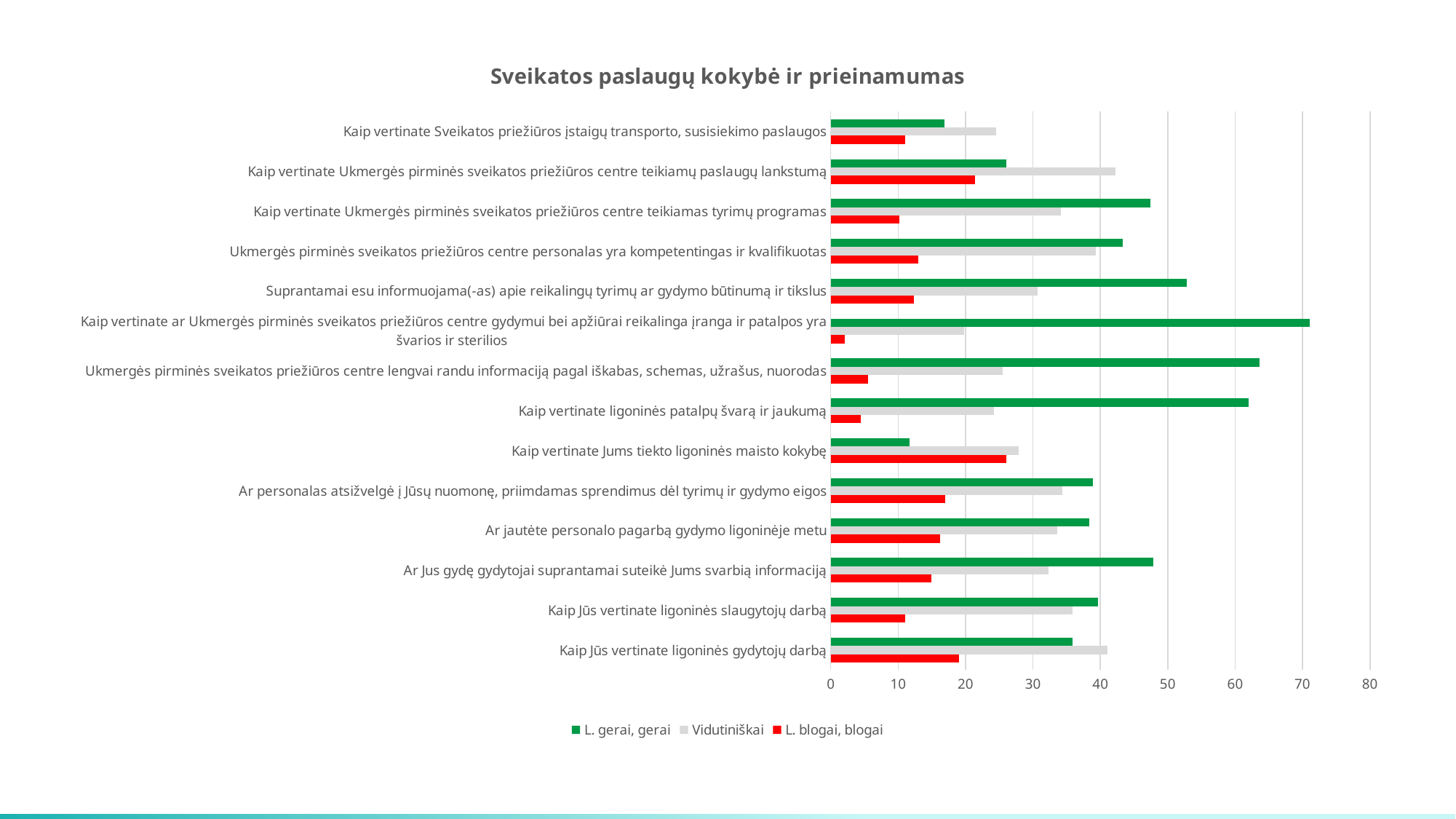
What type of chart is shown on the slide? bar chart Is the 'L. gerai, gerai' value for 'Kaip vertinate Sveikatos priežiūros įstaigų transporto, susisiekimo paslaugos' greater or less than 20? less How many categories (questions) are shown on the vertical axis? 14 Which category has the lowest value for the 'L. blogai, blogai' series? Kaip vertinate ar Ukmergės pirminės sveikatos priežiūros centre gydymui bei apžiūrai reikalinga įranga ir patalpos yra švarios ir sterilios Which colour represents the 'L. blogai, blogai' series? red What is the title of the chart? Sveikatos paslaugų kokybė ir prieinamumas For 'Kaip Jūs vertinate ligoninės gydytojų darbą', which series has the larger value: 'L. gerai, gerai' or 'Vidutiniškai'? Vidutiniškai Is the 'L. gerai, gerai' value for 'Kaip vertinate ligoninės patalpų švarą ir jaukumą' greater or less than 60? greater Which category has the highest value for the 'L. blogai, blogai' series? Kaip vertinate Jums tiekto ligoninės maisto kokybę How many series does the legend list? 3 Which category has the highest value for the 'L. gerai, gerai' series? Kaip vertinate ar Ukmergės pirminės sveikatos priežiūros centre gydymui bei apžiūrai reikalinga įranga ir patalpos yra švarios ir sterilios Which category has the lowest value for the 'L. gerai, gerai' series? Kaip vertinate Jums tiekto ligoninės maisto kokybę